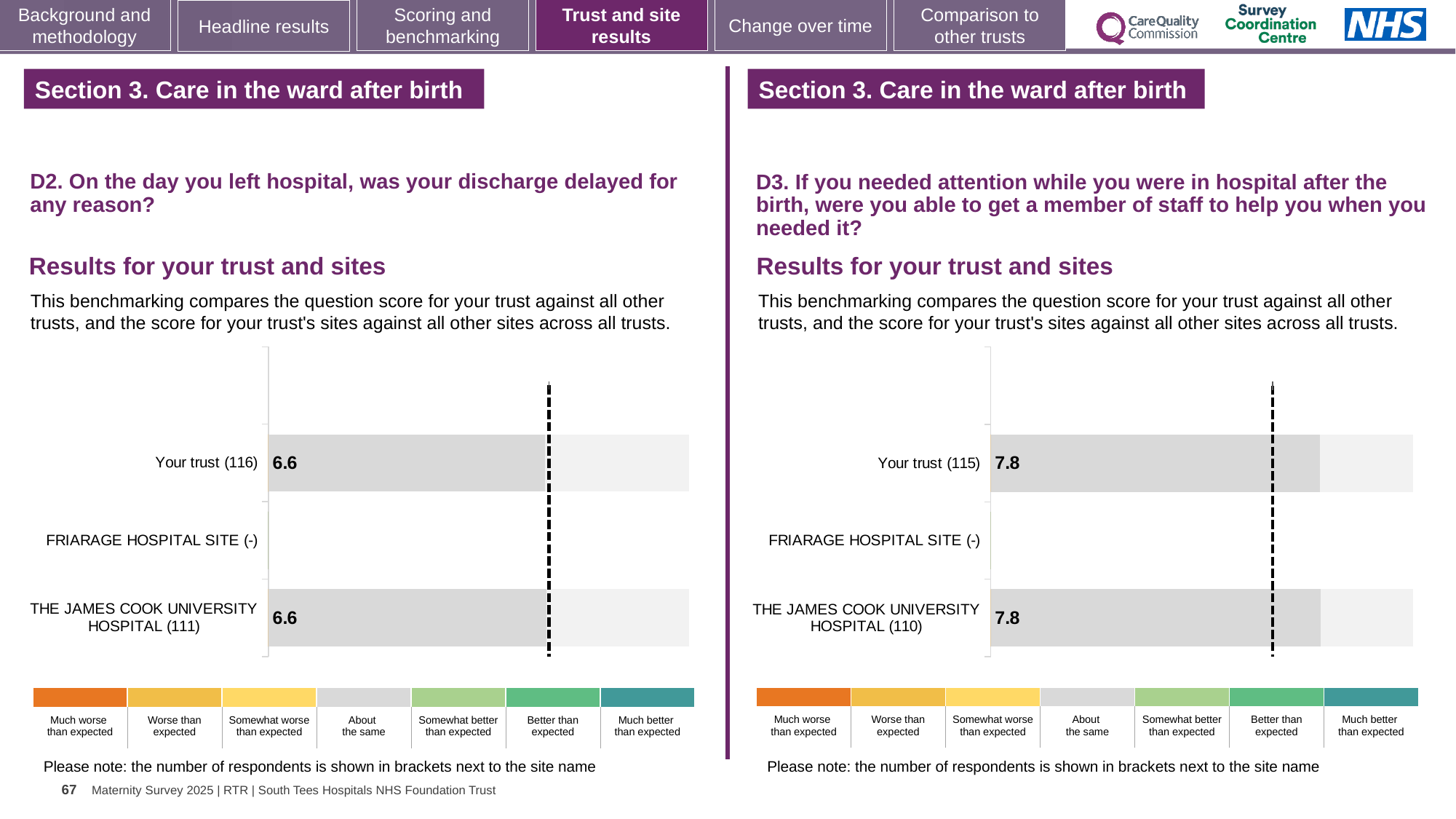
In the D3 chart on the right, what is the difference between the score for Your trust and the score for THE JAMES COOK UNIVERSITY HOSPITAL? 0 In the D2 chart on the left, what is the score for Your trust (116)? 6.6 In the D3 chart on the right, what is the score for THE JAMES COOK UNIVERSITY HOSPITAL (110)? 7.8 How many respondents are shown in brackets for Your trust in the D3 chart on the right? 115 In the D2 chart on the left, what is the difference between the score for Your trust and the score for THE JAMES COOK UNIVERSITY HOSPITAL? 0 How many site/trust rows are listed in the D2 chart on the left? 3 What kind of chart is used in the D2 chart on the left? Bar chart In the D2 chart on the left, which row has no bar plotted? FRIARAGE HOSPITAL SITE (-) How many benchmark categories are shown in the colour legend below the D2 chart on the left? 7 How many site/trust rows are listed in the D3 chart on the right? 3 In the D3 chart on the right, what is the score for Your trust (115)? 7.8 In the D2 chart on the left, what is the score for THE JAMES COOK UNIVERSITY HOSPITAL (111)? 6.6